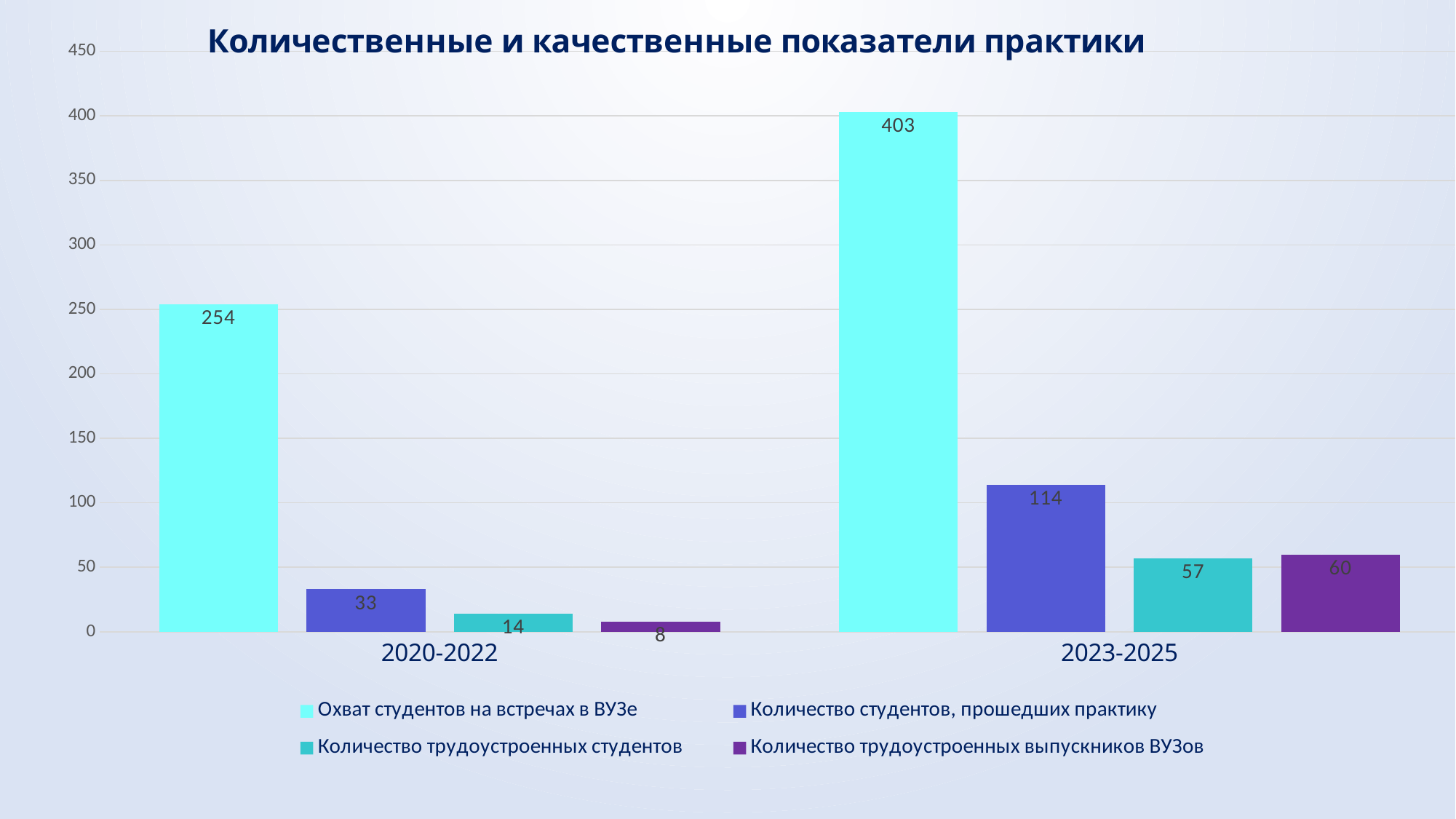
Which period has the higher value for 'Охват студентов на встречах в ВУЗе'? 2023-2025 Which series has the highest value in 2023-2025? Охват студентов на встречах в ВУЗе What is the value of 'Количество студентов, прошедших практику' for 2023-2025? 114 What type of chart is shown on the slide? Bar chart What is the value of 'Количество трудоустроенных выпускников ВУЗов' for 2020-2022? 8 What is the value of 'Охват студентов на встречах в ВУЗе' for 2020-2022? 254 What is the difference between 'Охват студентов на встречах в ВУЗе' in 2023-2025 and in 2020-2022? 149 How many series does the legend list? 4 Which series has the lowest value in 2020-2022? Количество трудоустроенных выпускников ВУЗов What is the difference between 'Количество студентов, прошедших практику' in 2023-2025 and in 2020-2022? 81 How many categories are shown on the x axis? 2 What is the value of 'Количество трудоустроенных студентов' for 2023-2025? 57